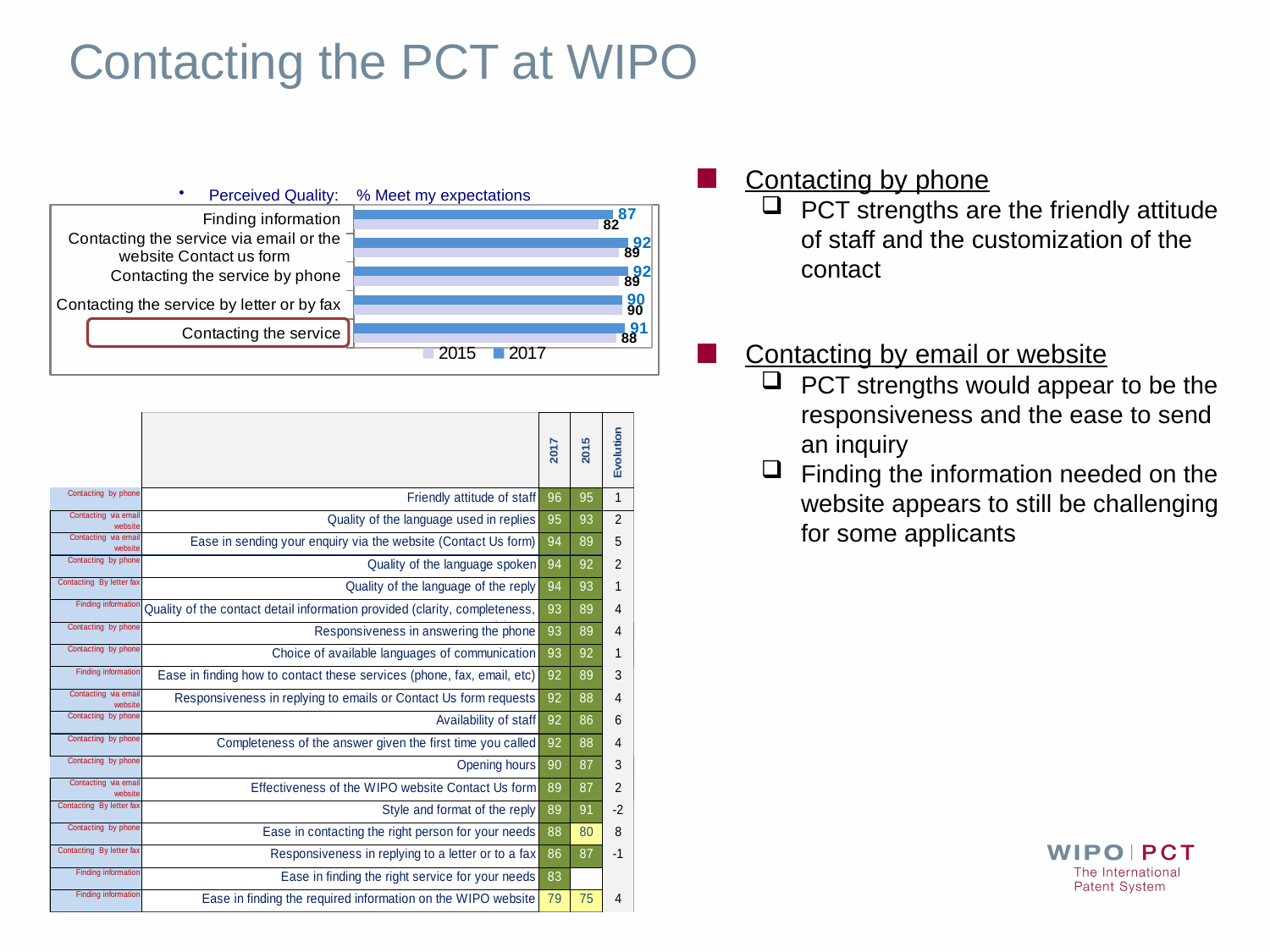
How many categories are shown in the Perceived Quality chart? 5 What is the 2015 value for Finding information in the Perceived Quality chart? 82 What is the 2017 value for Contacting the service in the Perceived Quality chart? 91 What is the 2017 value for Contacting the service by phone in the Perceived Quality chart? 92 What is the 2015 value for Contacting the service by letter or by fax in the Perceived Quality chart? 90 Which category has the lowest 2015 value in the Perceived Quality chart? Finding information Which years are listed in the legend of the Perceived Quality chart? 2015 and 2017 What is the 2017 value for Finding information in the Perceived Quality chart? 87 What type of chart is the Perceived Quality chart? Bar chart How many series does the legend of the Perceived Quality chart list? 2 In the Perceived Quality chart, is the 2017 value for Contacting the service larger than the 2015 value? Yes What is the difference between the 2017 and 2015 values for Finding information in the Perceived Quality chart? 5